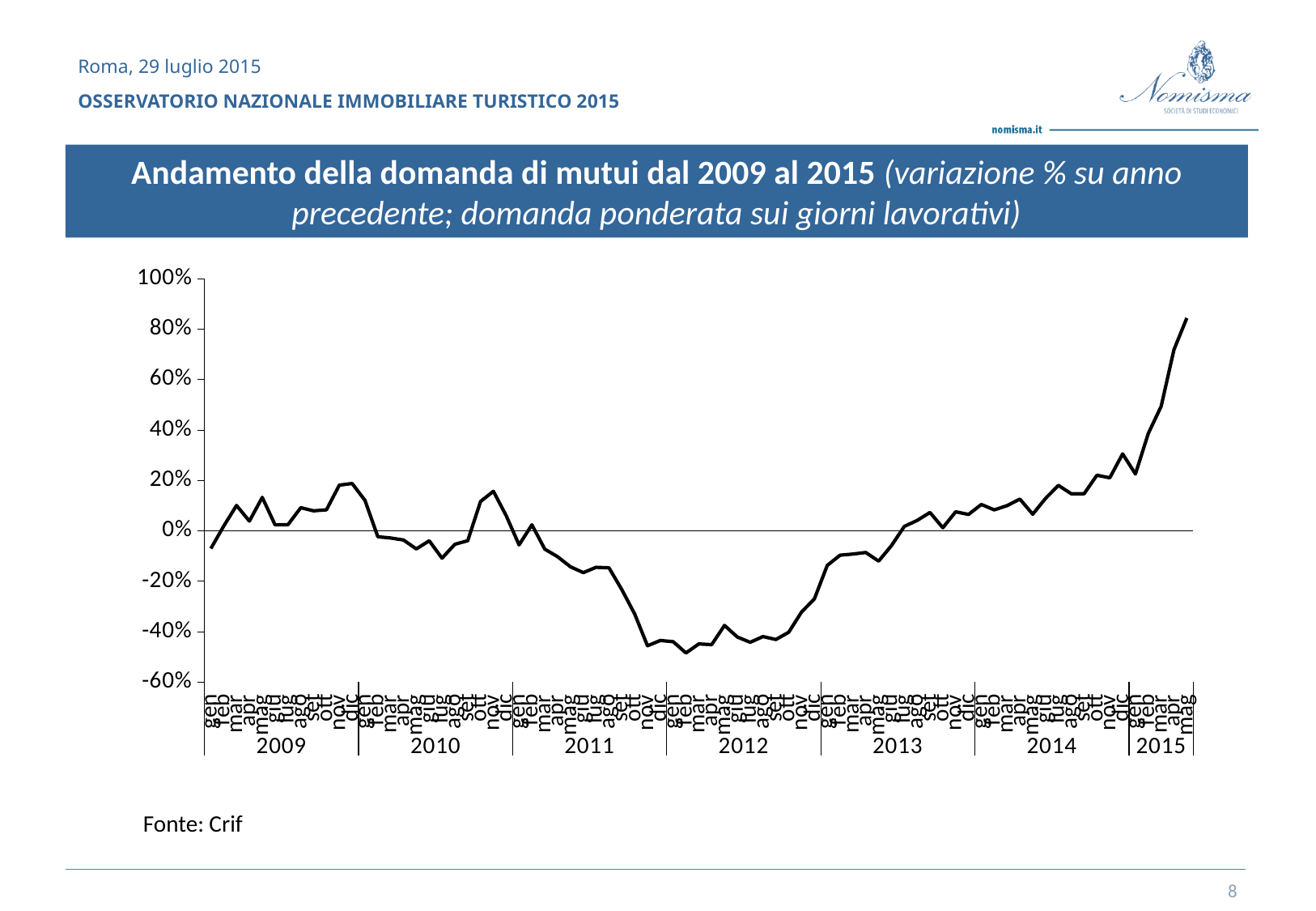
In which year does the line reach its highest value? 2015 How many lines are plotted on the chart? 1 Does the line generally rise or fall from gen 2011 to feb 2012? fall In which year does the line reach its lowest value? 2012 Does the line generally rise or fall from the start of 2012 to mag 2015? rise Is the value for mag 2015 greater or less than 60%? greater Is the value for feb 2012 greater or less than -40%? less Is the value for gen 2009 greater or less than 0%? less How many years are labelled along the x axis of the chart? 7 What kind of chart is shown on the slide? line chart What source is cited below the chart? Crif